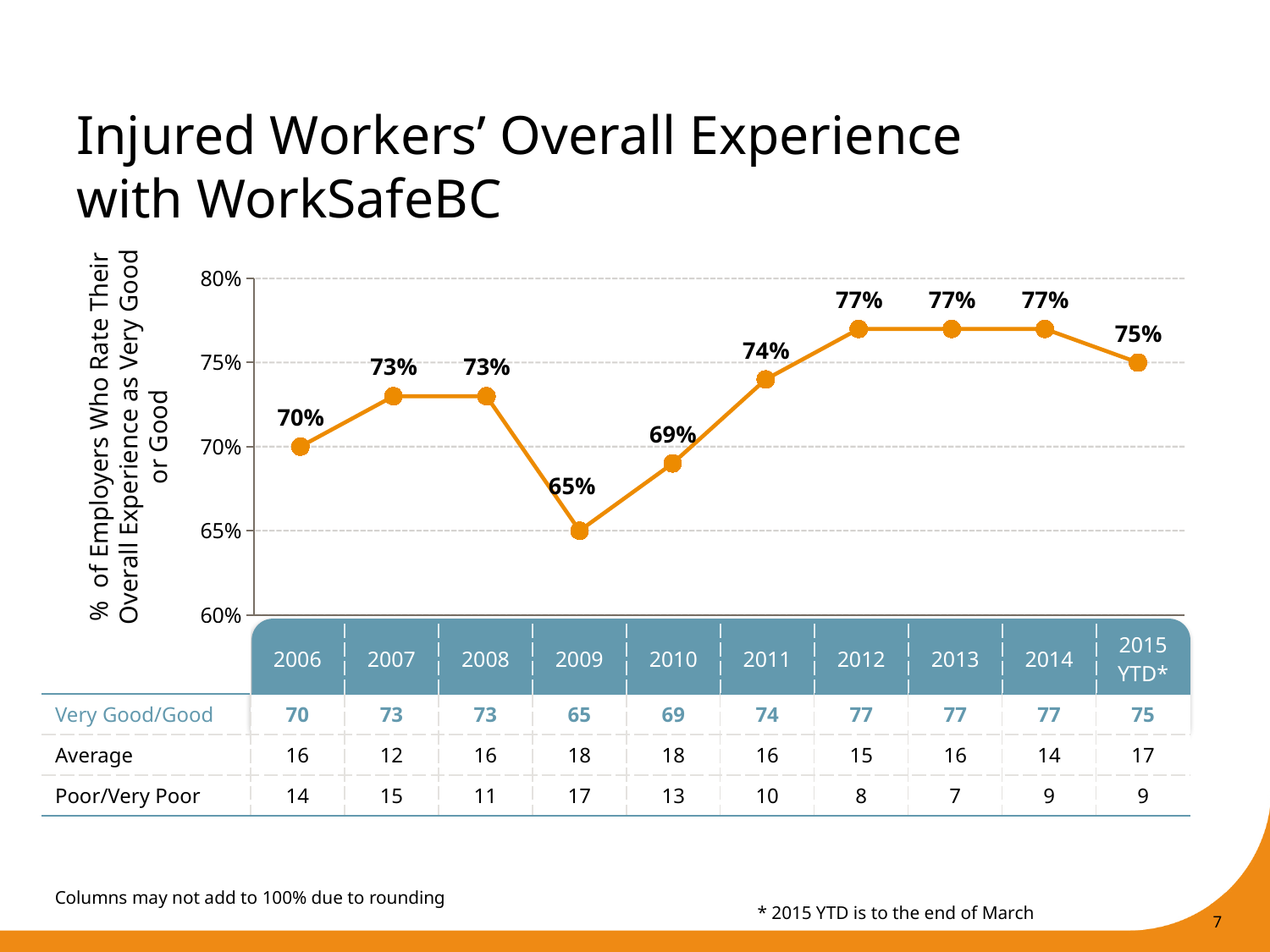
What is the difference between the values for 2014 and 2015 YTD*? 2% What is the value for 2011? 74% Do the values rise or fall from 2009 to 2012? rise What is the title of the slide containing the chart? Injured Workers' Overall Experience with WorkSafeBC What is the value for 2009? 65% What kind of chart is shown on the slide? line chart Which year has the lowest value? 2009 Which is larger, the value for 2010 or the value for 2007? 2007 Is the value for 2006 greater or less than 65%? greater What is the value for 2015 YTD*? 75% What is the difference between the values for 2012 and 2009? 12% How many years are plotted on the chart? 10